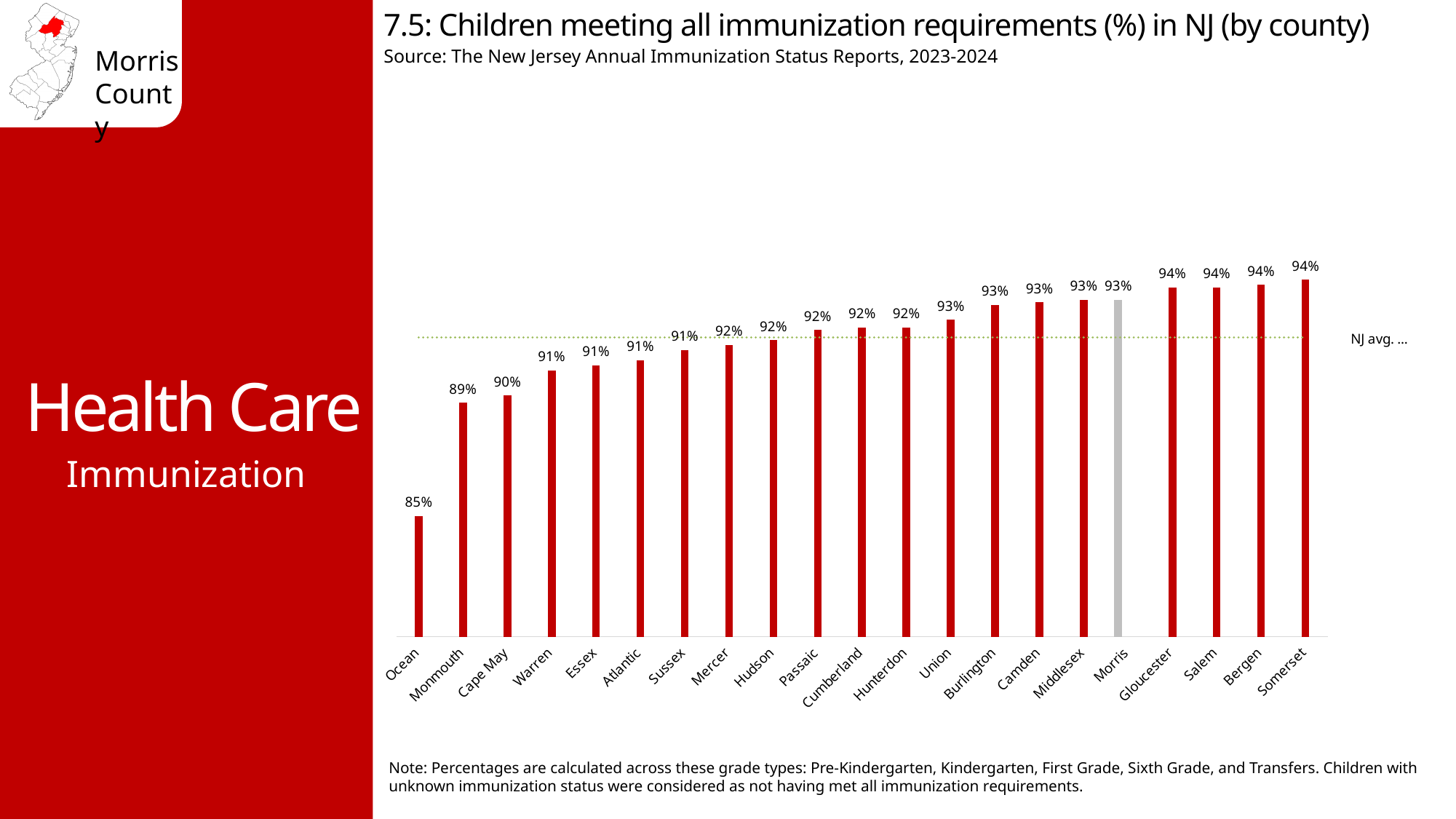
Which has a higher value, Monmouth or Warren? Warren What is the value shown for Morris County? 93% Which has a higher value, Ocean or Cape May? Cape May What is the difference in percentage points between Morris (93%) and Ocean (85%)? 8 percentage points What percentage of children in Ocean County meet all immunization requirements? 85% How many counties are shown on the chart? 21 Which county's bar is coloured grey instead of red? Morris What kind of chart is shown on the slide? Bar chart Do the values rise or fall moving from left to right across the chart? Rise What percentage is shown for Cape May? 90% What is the value for Somerset County? 94% Which county has the lowest percentage of children meeting all immunization requirements? Ocean